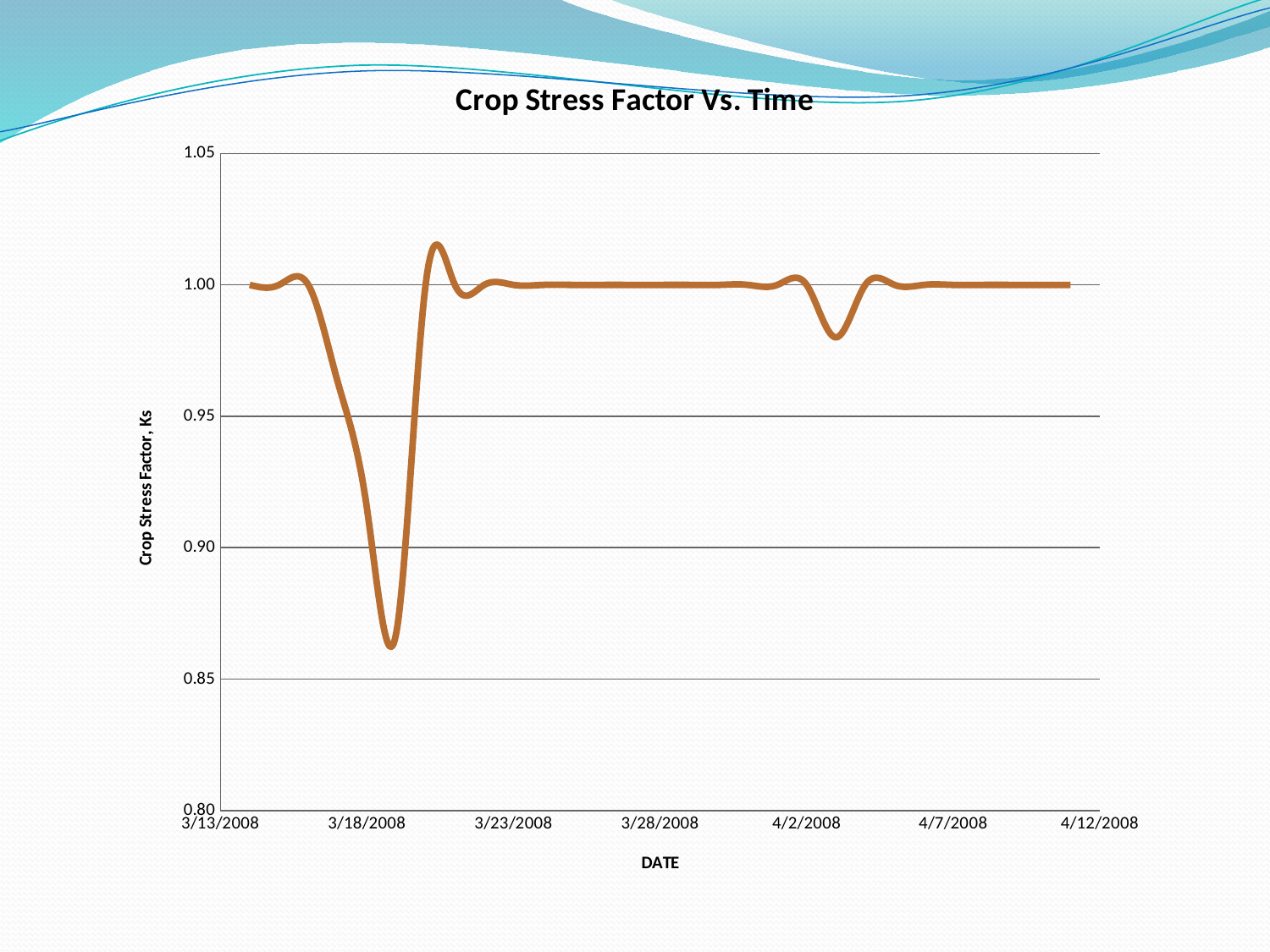
Is the lowest value of the crop stress factor on the chart greater or less than 0.90? less Which is larger, the crop stress factor on 3/18/2008 or on 3/28/2008? 3/28/2008 What kind of chart is shown on the slide? line chart Is the lowest value of the crop stress factor on the chart greater or less than 0.85? greater Is the value of the crop stress factor on 3/18/2008 greater or less than 0.85? greater How many data series are plotted on the chart? 1 What is the title of the chart? Crop Stress Factor Vs. Time What is the label on the vertical axis of the chart? Crop Stress Factor, Ks